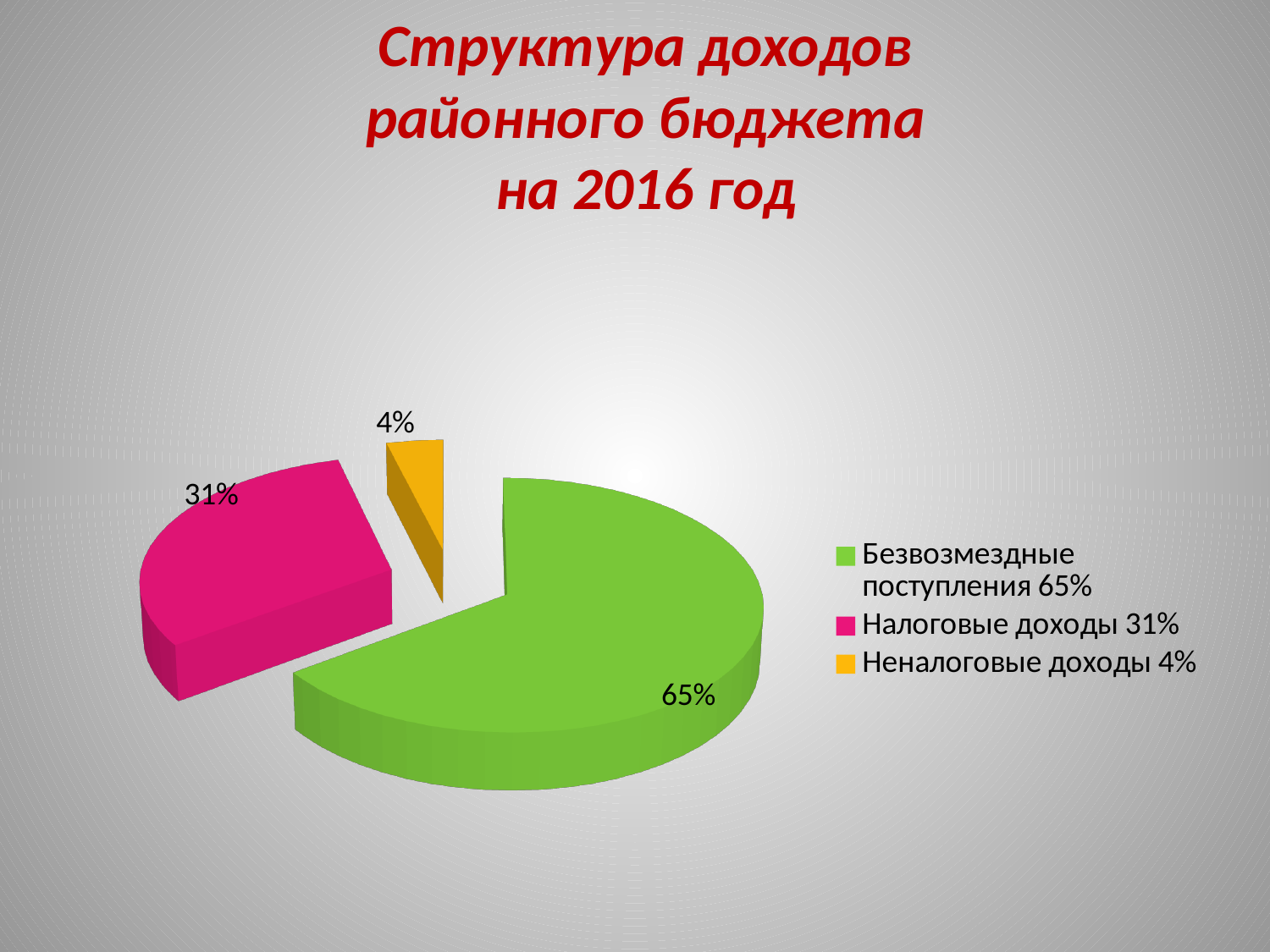
Which category has the largest slice of the pie? Безвозмездные поступления Which category has the smallest slice of the pie? Неналоговые доходы What share of the pie does Налоговые доходы take? 31% What is the difference in percentage points between Налоговые доходы and Неналоговые доходы? 27 What share of the pie does Неналоговые доходы take? 4% What share of the pie does Безвозмездные поступления take? 65% How many slices does the pie chart have? 3 What kind of chart is shown on the slide? pie chart What is the title of the chart on the slide? Структура доходов районного бюджета на 2016 год Which is larger, the slice for Налоговые доходы or the slice for Неналоговые доходы? Налоговые доходы What colour is the slice for Налоговые доходы? pink What is the difference in percentage points between Безвозмездные поступления and Налоговые доходы? 34